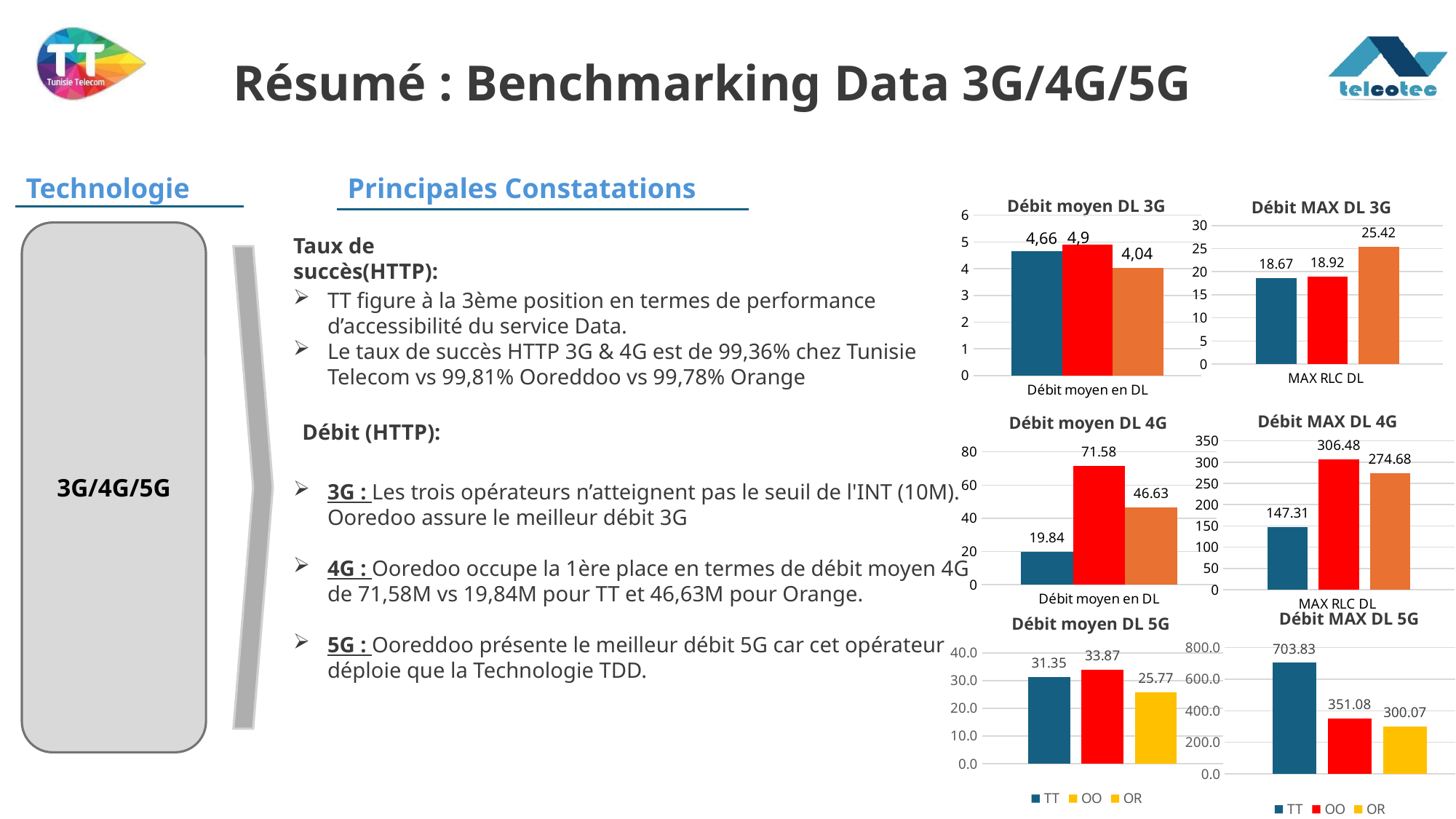
In the 'Débit moyen DL 4G' chart, what value is labelled on the red bar? 71.58 How many bars are shown in the 'Débit moyen DL 3G' chart? 3 What type of chart is 'Débit moyen DL 3G'? Bar chart In the 'Débit MAX DL 3G' chart, which is larger: the blue bar or the orange bar? The orange bar In the 'Débit MAX DL 5G' chart, what is the value for TT? 703.83 In the 'Débit MAX DL 3G' chart, what value is labelled on the orange bar? 25.42 In the 'Débit moyen DL 4G' chart, which bar has the lowest value? The blue bar (19.84) In the 'Débit moyen DL 5G' chart, what value is labelled on the third (yellow) bar? 25.77 In the 'Débit moyen DL 5G' chart, what is the difference between the second bar (33.87) and the first bar (31.35)? 2.52 How many series does the legend of the 'Débit MAX DL 5G' chart list? 3 In the 'Débit MAX DL 5G' chart, which operator has the highest value? TT In the 'Débit MAX DL 4G' chart, is the value of the blue bar greater or less than 200? less